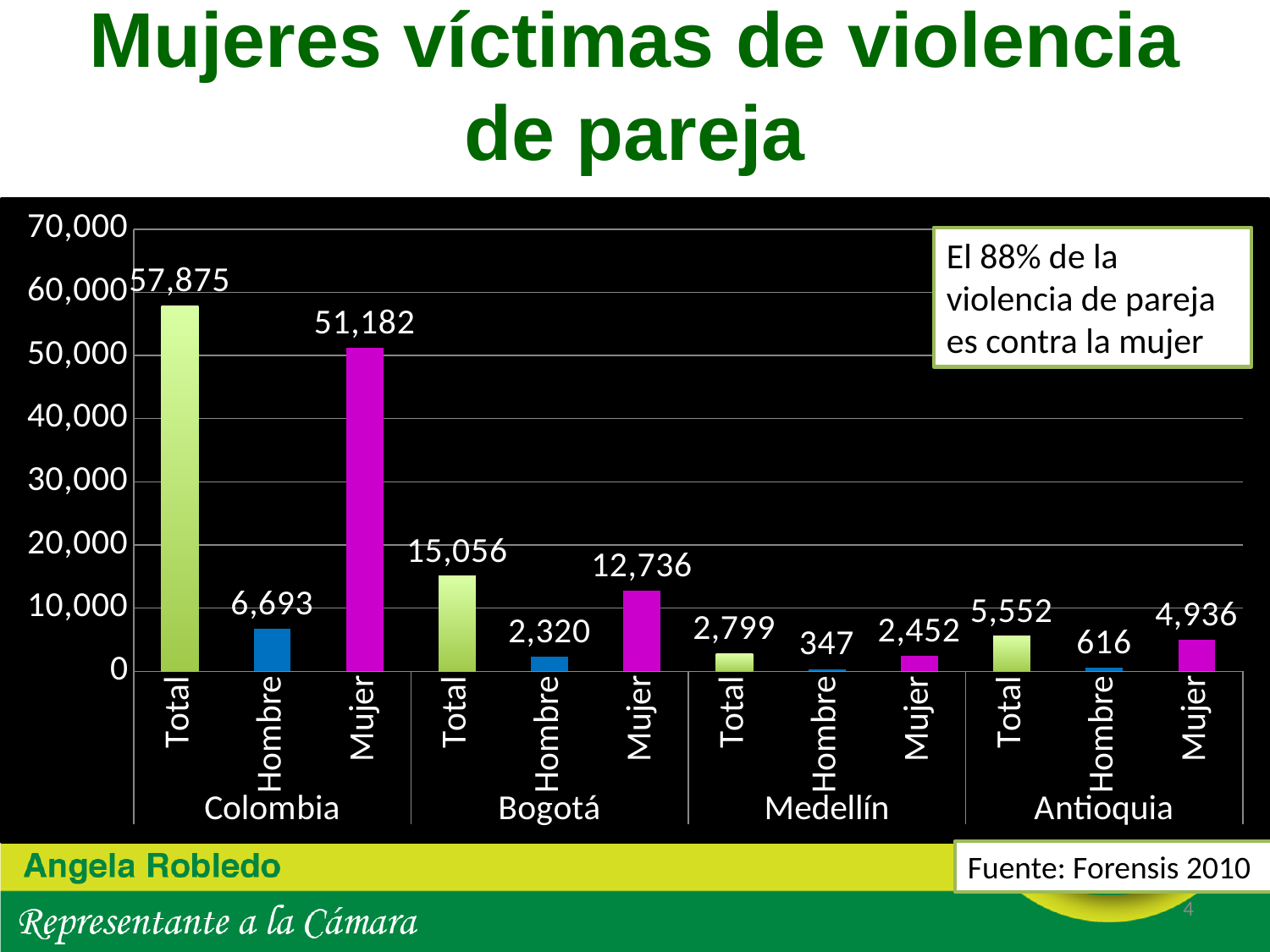
What is the value for Mujer in Colombia? 51,182 Which is larger: the Hombre value for Antioquia or the Hombre value for Medellín? Antioquia (616) According to the text box on the chart, what percentage of partner violence is against women? 88% What is the value for Hombre in Bogotá? 2,320 Which bar has the highest value on the chart? Total, Colombia (57,875) How many bars are plotted on the chart? 12 Which bar has the lowest value on the chart? Hombre, Medellín (347) What is the difference between the Mujer values for Colombia and Bogotá? 38,446 What is the Total value for Medellín? 2,799 What is the difference between the Total and the Mujer values for Bogotá? 2,320 What is the value for Mujer in Antioquia? 4,936 What kind of chart is shown on the slide? Bar chart